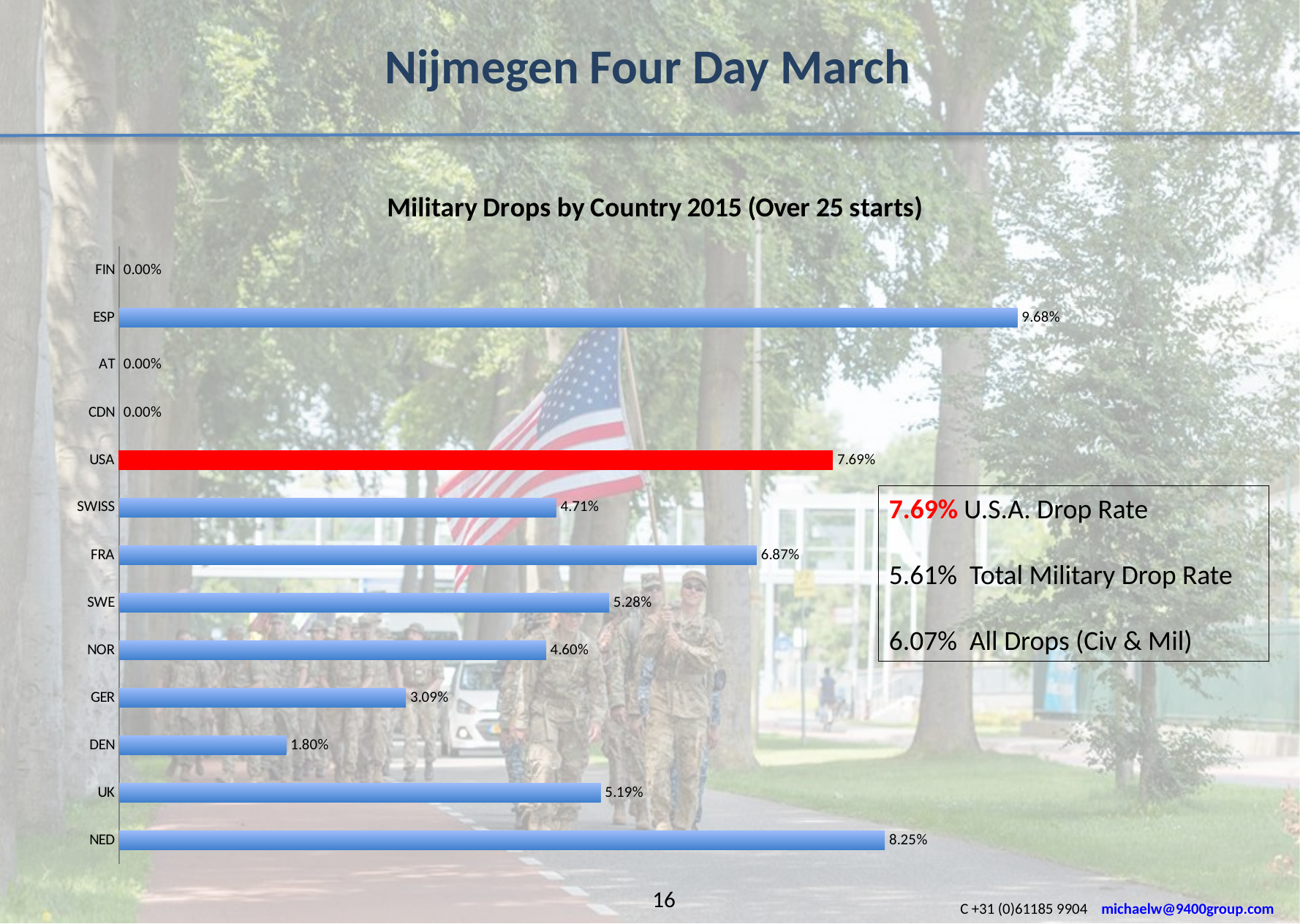
What is the difference between the drop rates of USA and FRA? 0.82% How many countries are listed in the chart? 13 How many countries in the chart show a drop rate of 0.00%? 3 What is the difference between the drop rates of ESP and NED? 1.43% Which country has the lowest non-zero military drop rate in the chart? DEN What kind of chart is shown on the slide? Bar chart Which country has the highest military drop rate in the chart? ESP What is the military drop rate for ESP? 9.68% Which country's bar is coloured red in the chart? USA What is the military drop rate for NED? 8.25% What is the military drop rate for GER? 3.09% Which has a higher drop rate, FRA or SWE? FRA